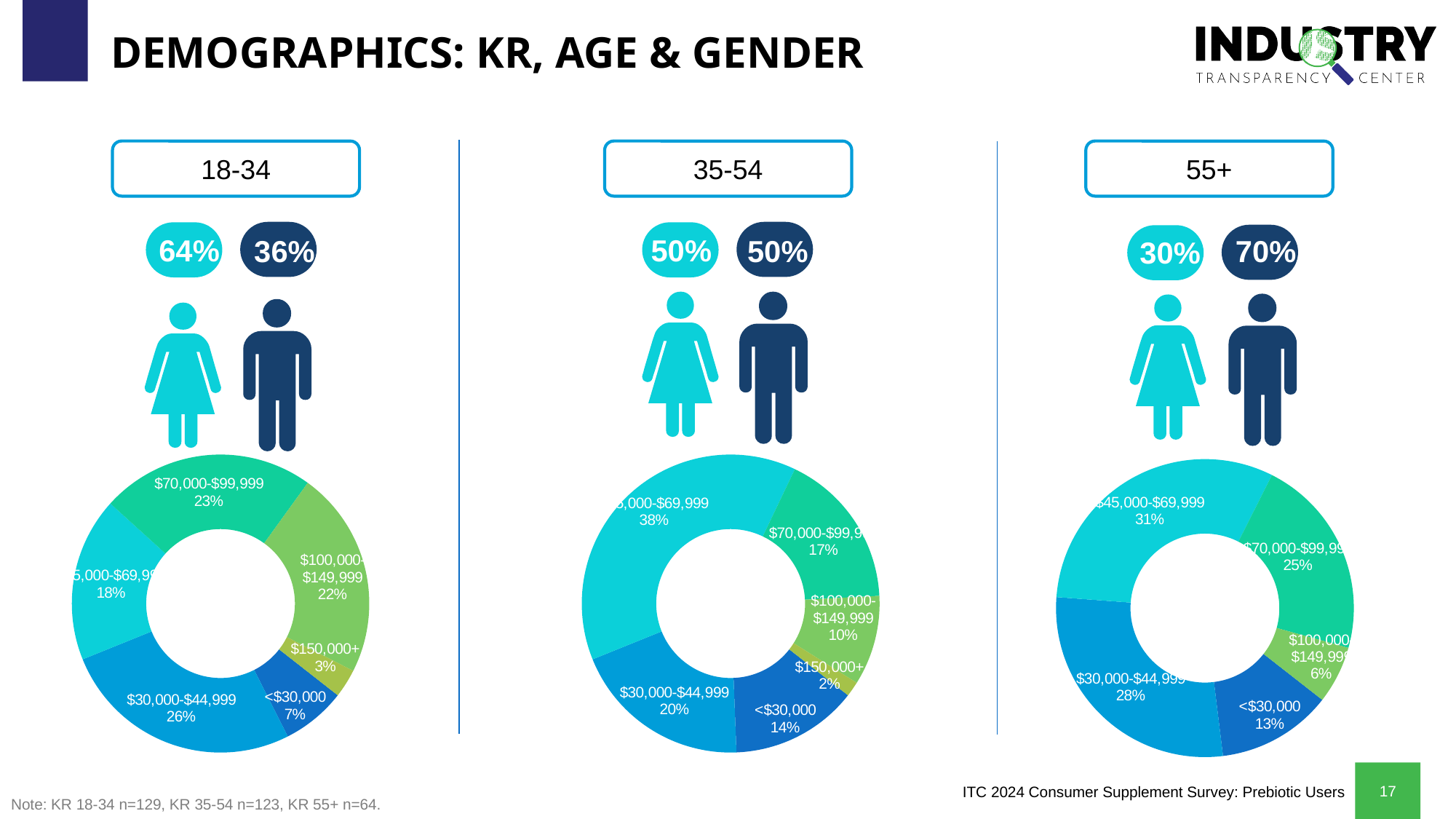
In the 35-54 donut chart, which income bracket has the largest share? $45,000-$69,999 In the 55+ age group, what percentage of respondents are male? 70% In the 18-34 donut chart, which income bracket has the smallest share? $150,000+ In the 35-54 donut chart, which is larger: the $70,000-$99,999 share or the $100,000-$149,999 share? $70,000-$99,999 What type of chart is used to show the income distribution for each age group? Donut (pie) chart In the 55+ donut chart, what share of respondents are in the $100,000-$149,999 income bracket? 6% In the 18-34 donut chart, what is the difference between the $30,000-$44,999 share and the <$30,000 share? 19 percentage points In the 18-34 donut chart, what share of respondents are in the $30,000-$44,999 income bracket? 26% In the 55+ donut chart, which income bracket has the largest share? $45,000-$69,999 In the 55+ donut chart, what is the difference between the $30,000-$44,999 share and the <$30,000 share? 15 percentage points How many income brackets are shown in the 18-34 donut chart? 6 In the 35-54 donut chart, what share of respondents are in the $45,000-$69,999 income bracket? 38%